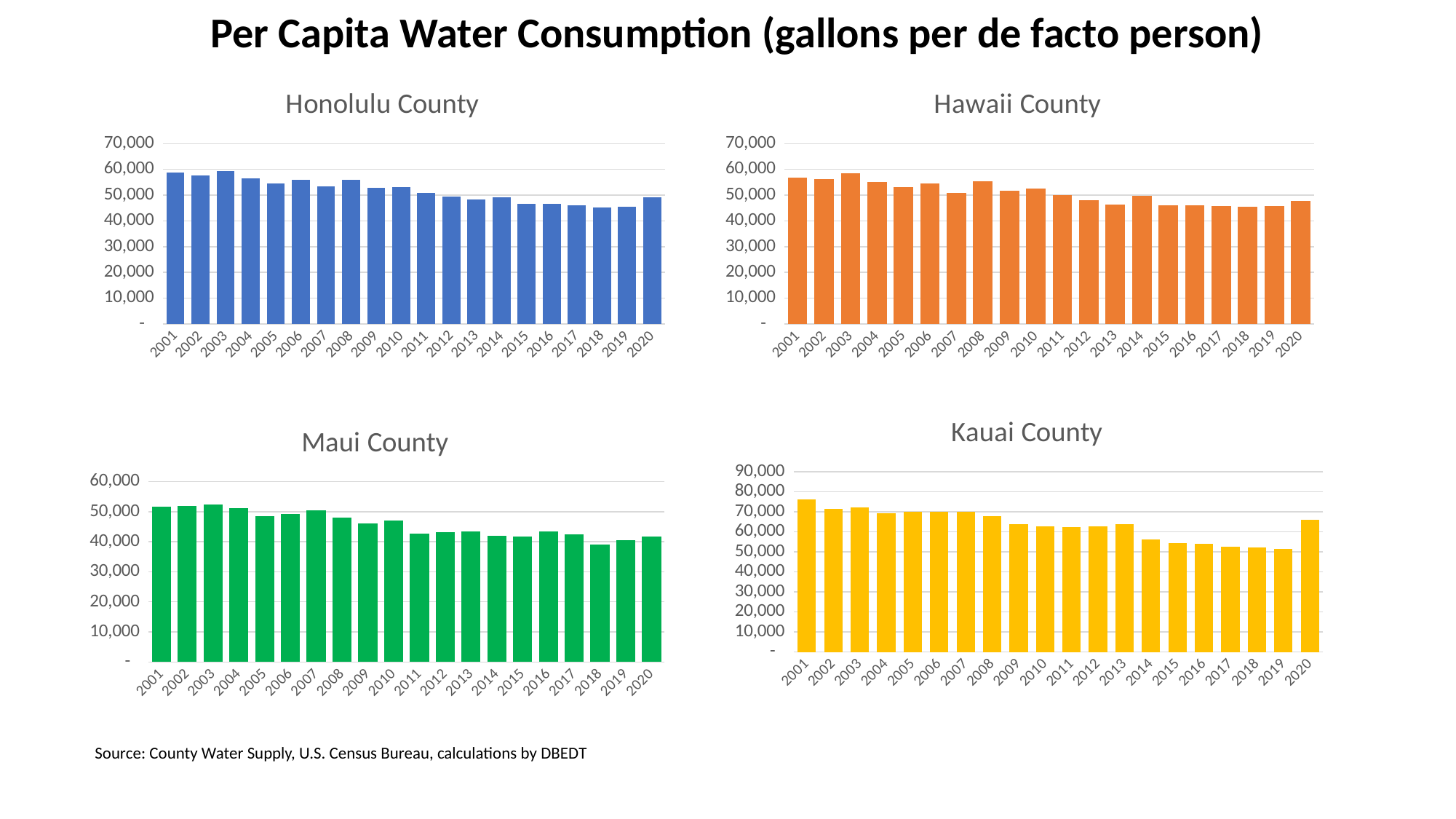
In the Honolulu County chart, is the value for 2001 greater or less than 50,000? greater In the Kauai County chart, which is larger, the value for 2001 or the value for 2020? 2001 In the Honolulu County chart, is the value for 2018 greater or less than 50,000? less In the Kauai County chart, is the value for 2020 greater or less than 60,000? greater In the Hawaii County chart, which year has the highest value? 2003 In the Kauai County chart, which year has the highest value? 2001 How many years are plotted in the Maui County chart? 20 In the Honolulu County chart, do the values generally rise or fall from 2001 to 2019? fall In the Maui County chart, which year has the lowest value? 2018 What kind of chart is the Honolulu County chart? bar chart